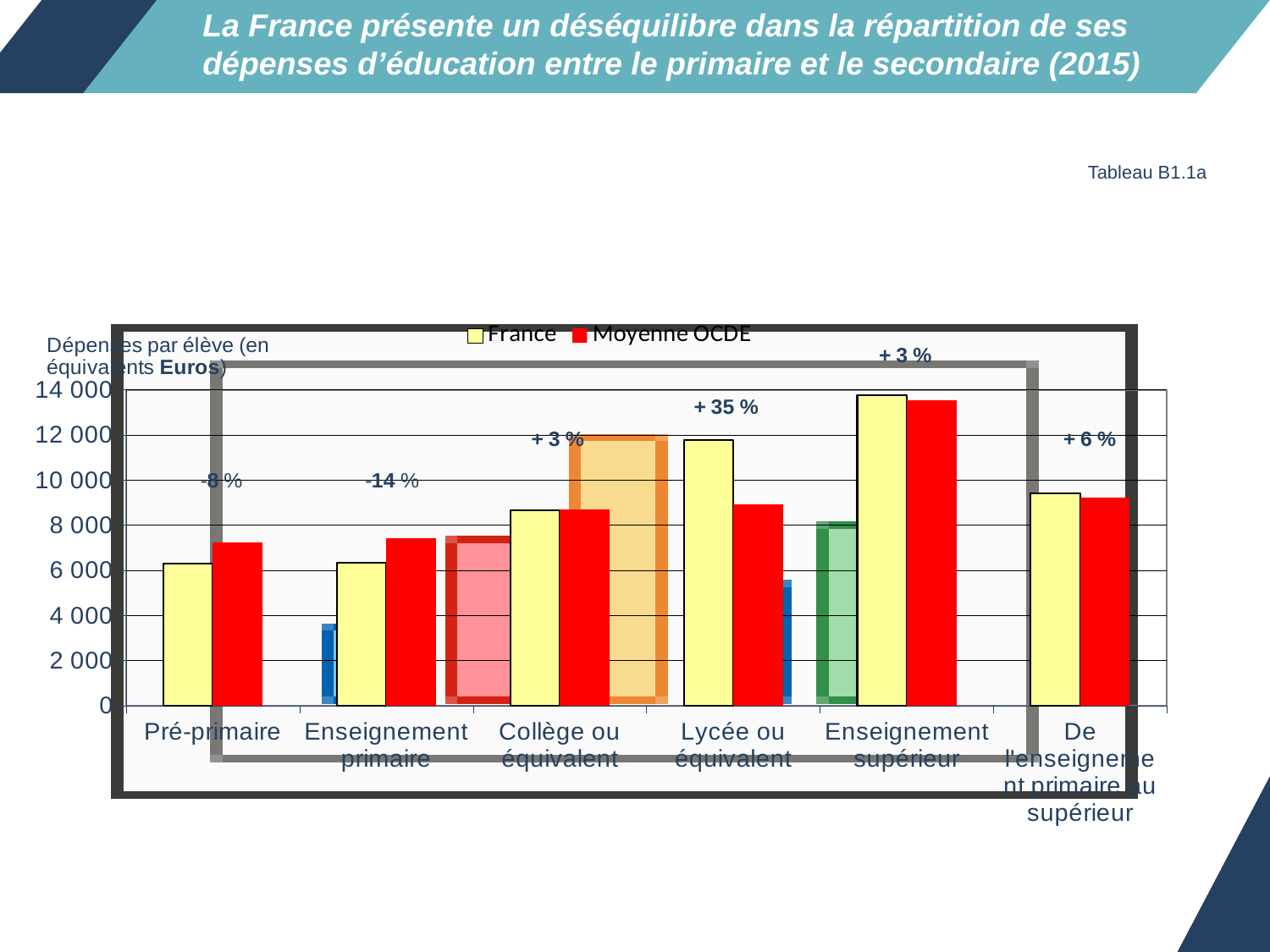
How many series does the chart legend list? 2 Is the Moyenne OCDE value for Pré-primaire greater or less than 8 000? less Is the France value for Lycée ou équivalent greater or less than 10 000? greater How many categories are shown on the x axis of the chart? 6 For which category is the Moyenne OCDE value highest? Enseignement supérieur For Lycée ou équivalent, which is larger: France or Moyenne OCDE? France For Pré-primaire, which is larger: France or Moyenne OCDE? Moyenne OCDE For which category is the France value highest? Enseignement supérieur Which series is shown in red in the chart? Moyenne OCDE Which series is shown in yellow in the chart? France Is the France value for Enseignement supérieur greater or less than 12 000? greater What kind of chart is shown on the slide? bar chart